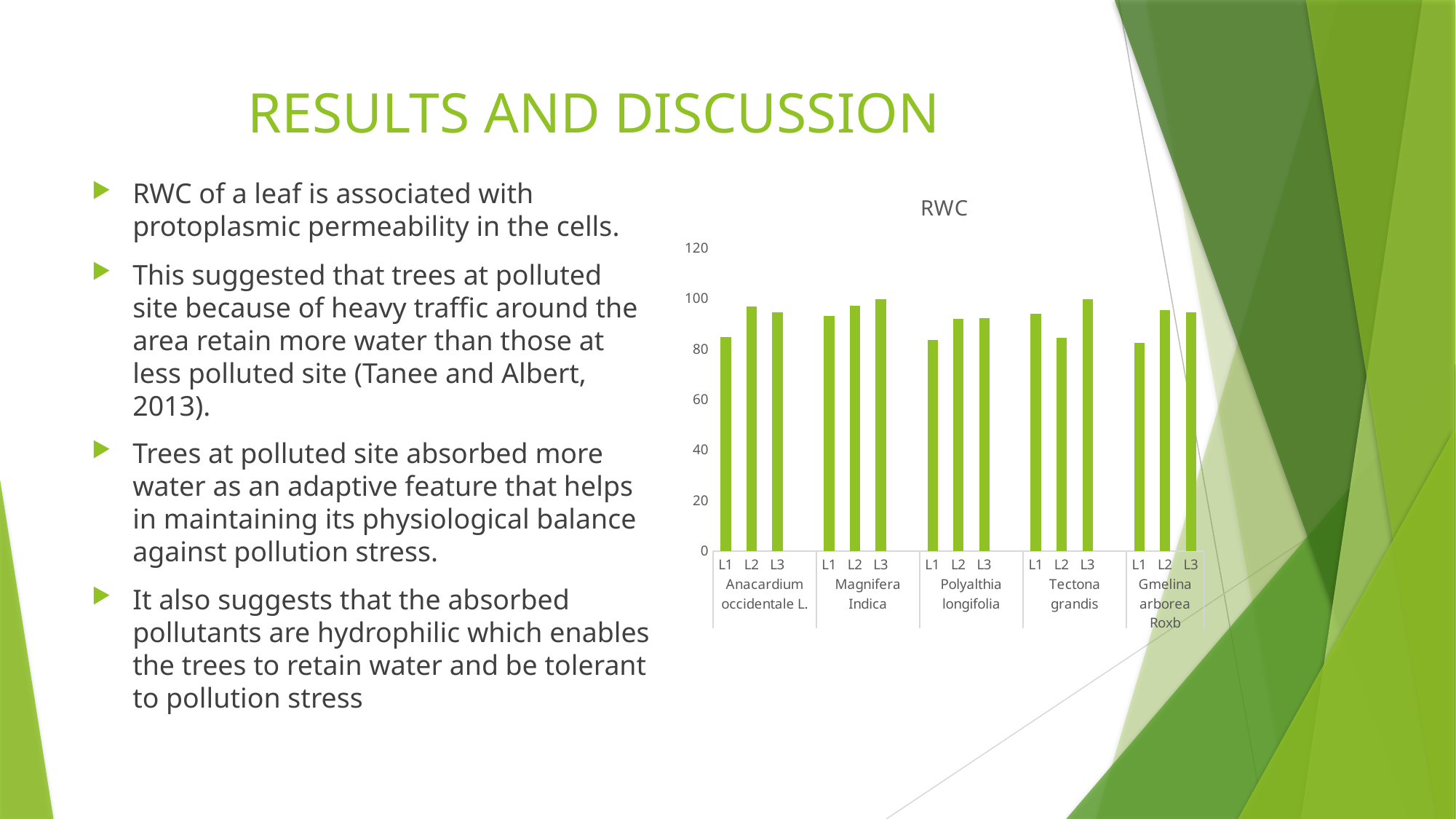
Which is larger, the RWC value for L2 or L3 of Tectona grandis? L3 Is the RWC value for L1 of Anacardium occidentale L. greater or less than 80? greater Among L1, L2 and L3 of Tectona grandis, which has the lowest RWC value? L2 What kind of chart is shown on the slide? bar chart What colour are the bars in the chart? green Among L1, L2 and L3 of Gmelina arborea Roxb, which has the lowest RWC value? L1 How many tree species are shown on the x axis of the chart? 5 How many bars are plotted in the chart in total? 15 Which is larger, the RWC value for L1 or L2 of Anacardium occidentale L.? L2 Is the RWC value for L2 of Tectona grandis greater or less than 100? less Is the RWC value for L1 of Polyalthia longifolia greater or less than 60? greater What is the title of the chart? RWC